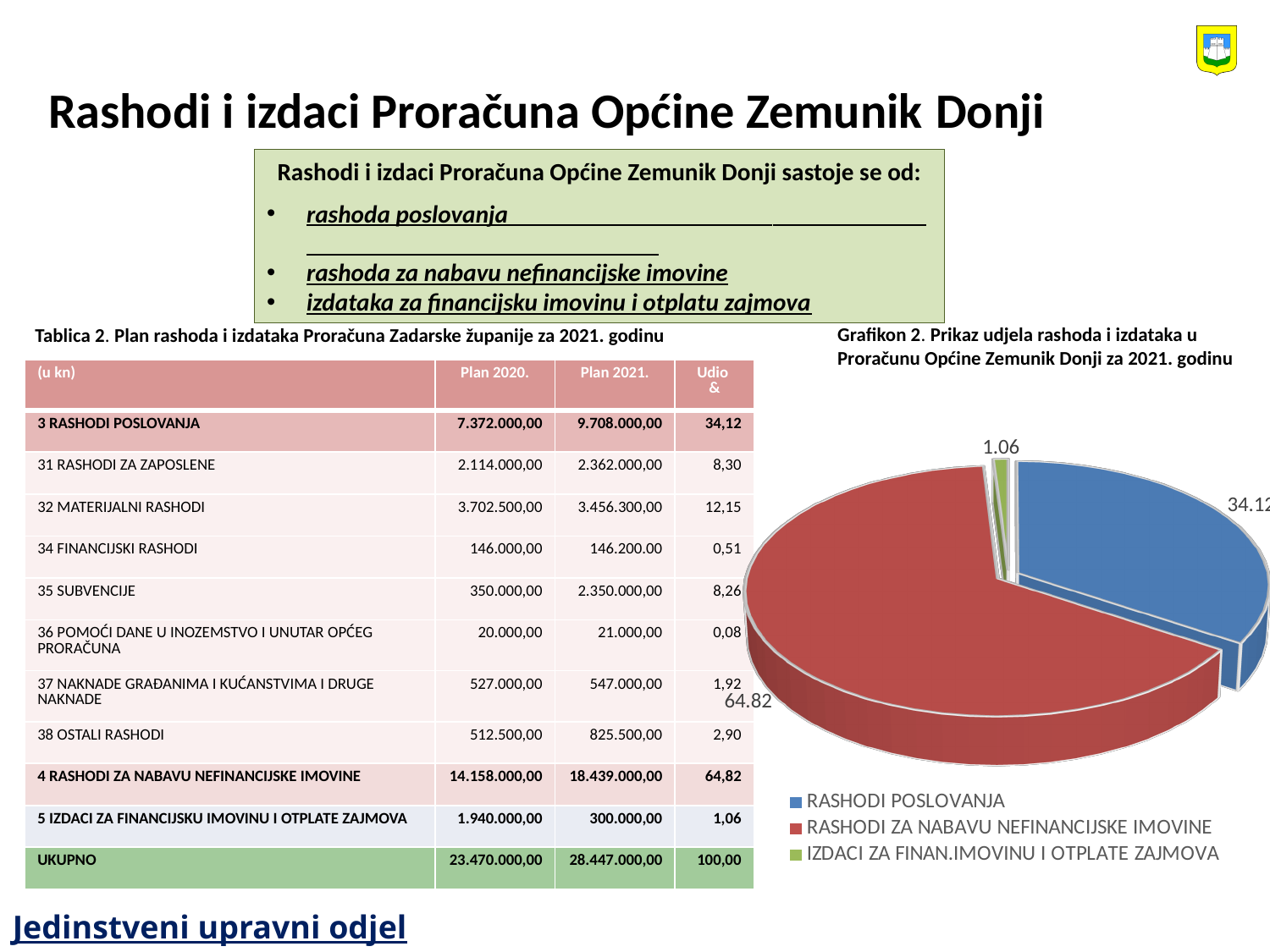
Which category has the largest slice in the pie chart? RASHODI ZA NABAVU NEFINANCIJSKE IMOVINE What kind of chart is shown in Grafikon 2 on the slide? pie chart In the pie chart, which is larger: RASHODI POSLOVANJA or RASHODI ZA NABAVU NEFINANCIJSKE IMOVINE? RASHODI ZA NABAVU NEFINANCIJSKE IMOVINE What is the difference between the labelled values for RASHODI ZA NABAVU NEFINANCIJSKE IMOVINE and IZDACI ZA FINAN.IMOVINU I OTPLATE ZAJMOVA in the pie chart? 63.76 Which category has the smallest slice in the pie chart? IZDACI ZA FINAN.IMOVINU I OTPLATE ZAJMOVA What value is labelled on the pie chart for RASHODI ZA NABAVU NEFINANCIJSKE IMOVINE? 64.82 How many entries does the pie chart's legend list? 3 How many slices does the pie chart have? 3 What value is labelled on the pie chart for IZDACI ZA FINAN.IMOVINU I OTPLATE ZAJMOVA? 1.06 What colour is the RASHODI POSLOVANJA slice in the pie chart? blue In the pie chart, which is larger: RASHODI POSLOVANJA or IZDACI ZA FINAN.IMOVINU I OTPLATE ZAJMOVA? RASHODI POSLOVANJA What colour is the RASHODI ZA NABAVU NEFINANCIJSKE IMOVINE slice in the pie chart? red